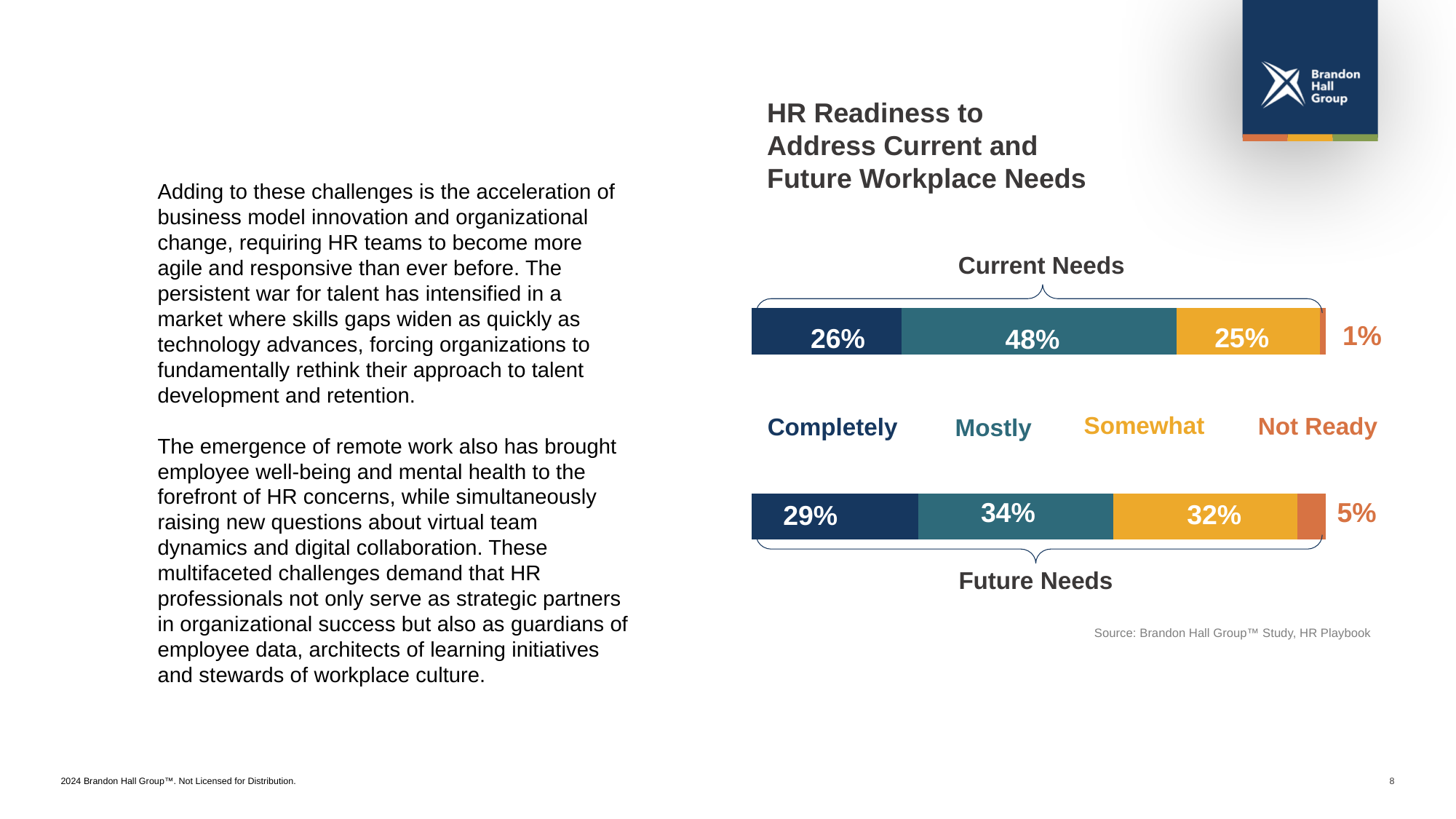
Which readiness level has the largest share for Current Needs? Mostly What percentage of respondents are 'Mostly' ready to address Current Needs? 48% Which is larger: the 'Somewhat' share for Current Needs or the 'Somewhat' share for Future Needs? Future Needs What type of chart is used to show HR readiness? Stacked bar chart What is the title of the chart? HR Readiness to Address Current and Future Workplace Needs What is the difference between the 'Mostly' share for Current Needs and the 'Mostly' share for Future Needs? 14% How many bars are shown in the chart? 2 What percentage of respondents are 'Completely' ready to address Future Needs? 29% Which readiness level has the smallest share for Future Needs? Not Ready What percentage of respondents are 'Somewhat' ready to address Current Needs? 25% What percentage of respondents are 'Not Ready' to address Future Needs? 5% How many readiness categories are shown in the legend? 4